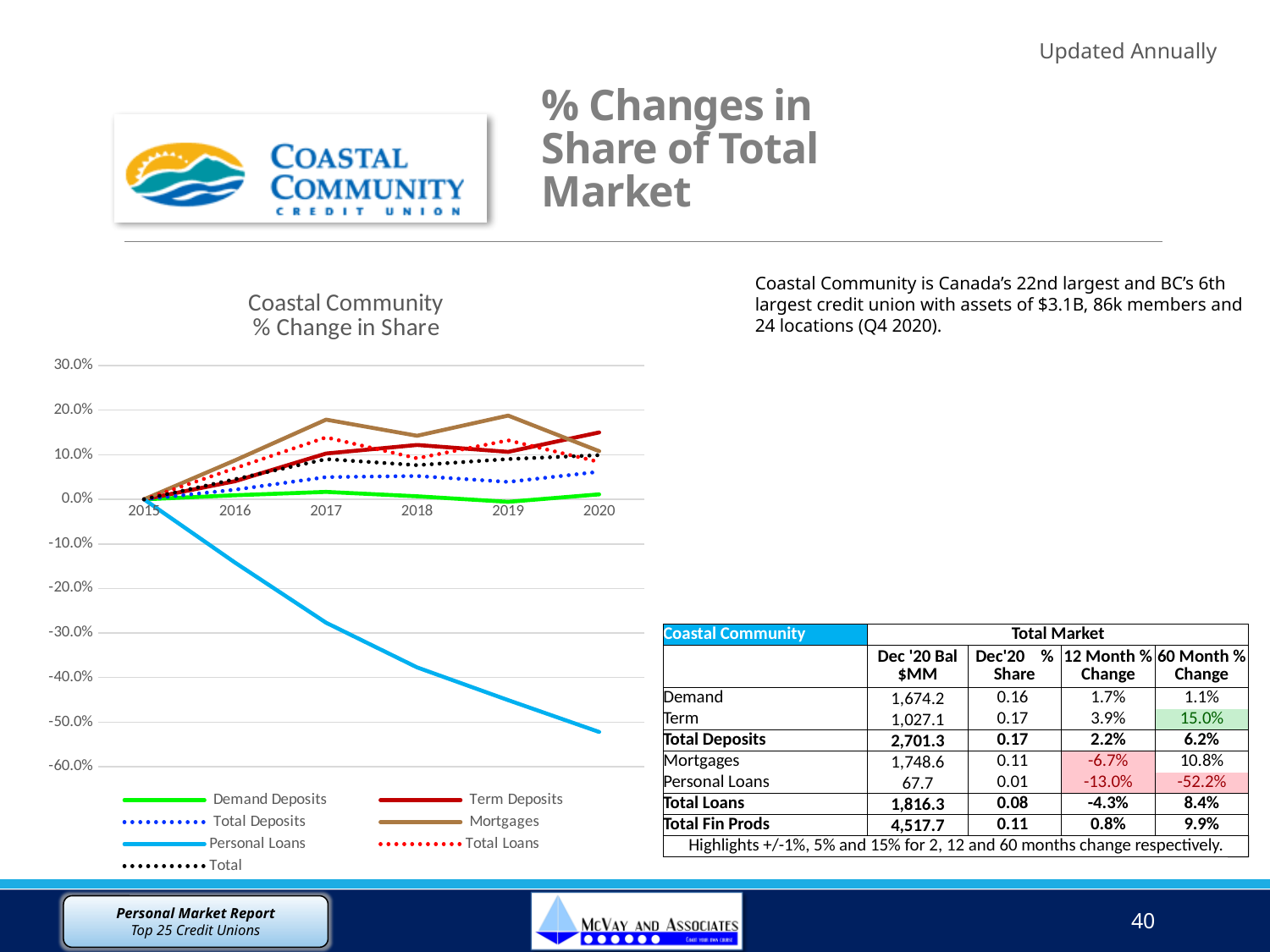
What is the value for Personal Loans in 2015? 0.0% In 2017, which is larger: the value for Mortgages or the value for Demand Deposits? Mortgages Is the value for Demand Deposits in 2020 greater or less than 10.0%? less Which series has the highest value in 2019? Mortgages How many series does the legend of the chart list? 7 Which series has the lowest value in 2020? Personal Loans Is the value for Personal Loans in 2020 greater or less than -40.0%? less What kind of chart is shown on the slide? line chart Does the Personal Loans line rise or fall from 2015 to 2020? fall Is the value for Mortgages in 2019 greater or less than 10.0%? greater What is the title of the chart? Coastal Community % Change in Share How many years are plotted along the x axis of the chart? 6